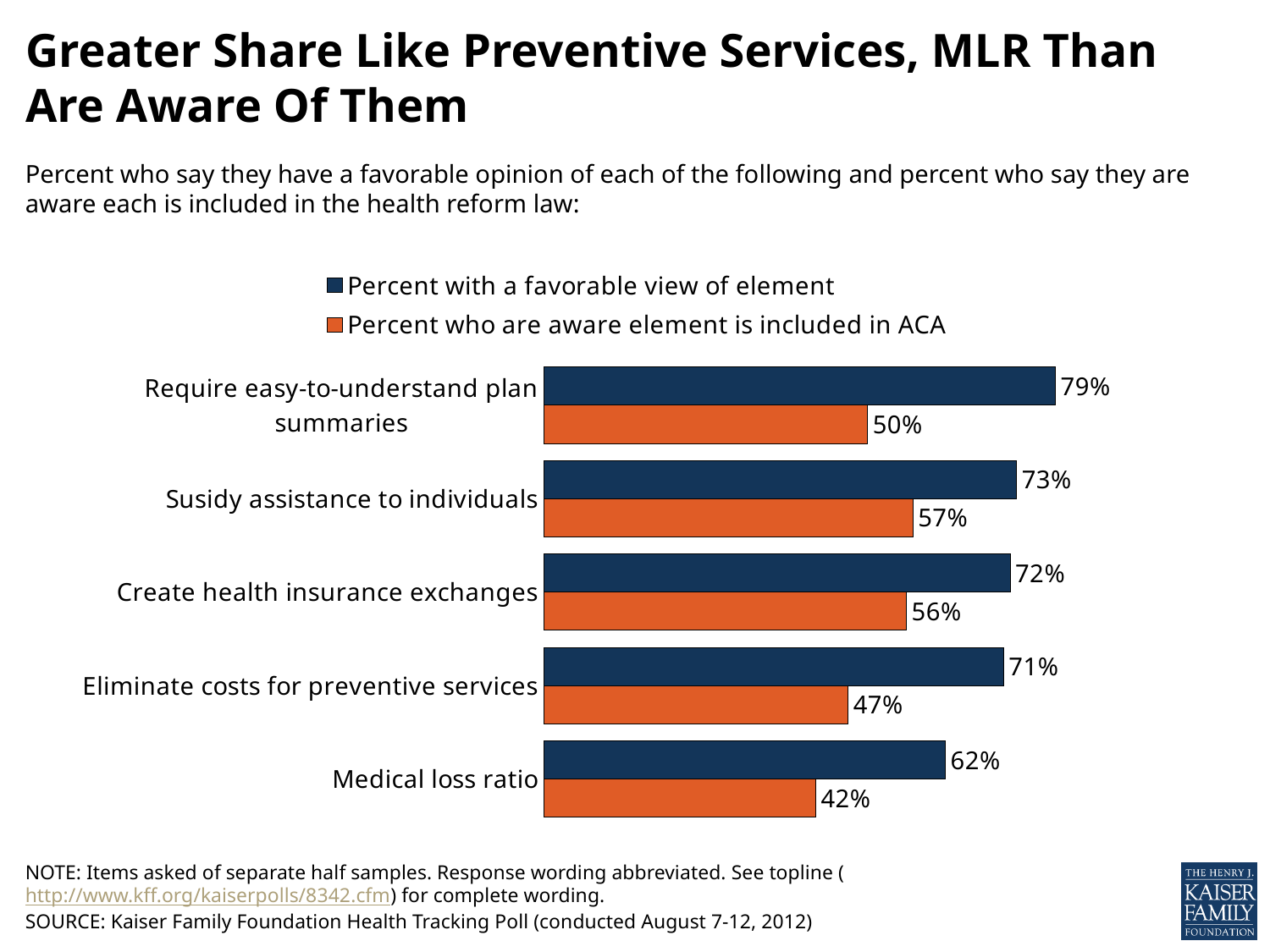
What percent have a favorable view of requiring easy-to-understand plan summaries? 79% How many series does the legend list? 2 How many elements are shown in the chart? 5 Which is larger: the percent aware that health insurance exchanges are included in the ACA, or the percent aware that easy-to-understand plan summaries are included? Create health insurance exchanges What percent are aware that the medical loss ratio is included in the ACA? 42% Which colour represents the percent who are aware the element is included in the ACA? Orange What is the difference between the favorable view percent for the medical loss ratio and for subsidy assistance to individuals? 11 percentage points What percent are aware that subsidy assistance to individuals is included in the ACA? 57% What kind of chart is shown on the slide? Bar chart Which element has the highest percent with a favorable view? Require easy-to-understand plan summaries What is the difference between the percent with a favorable view of eliminating costs for preventive services and the percent aware it is included in the ACA? 24 percentage points Which element has the lowest percent who are aware it is included in the ACA? Medical loss ratio